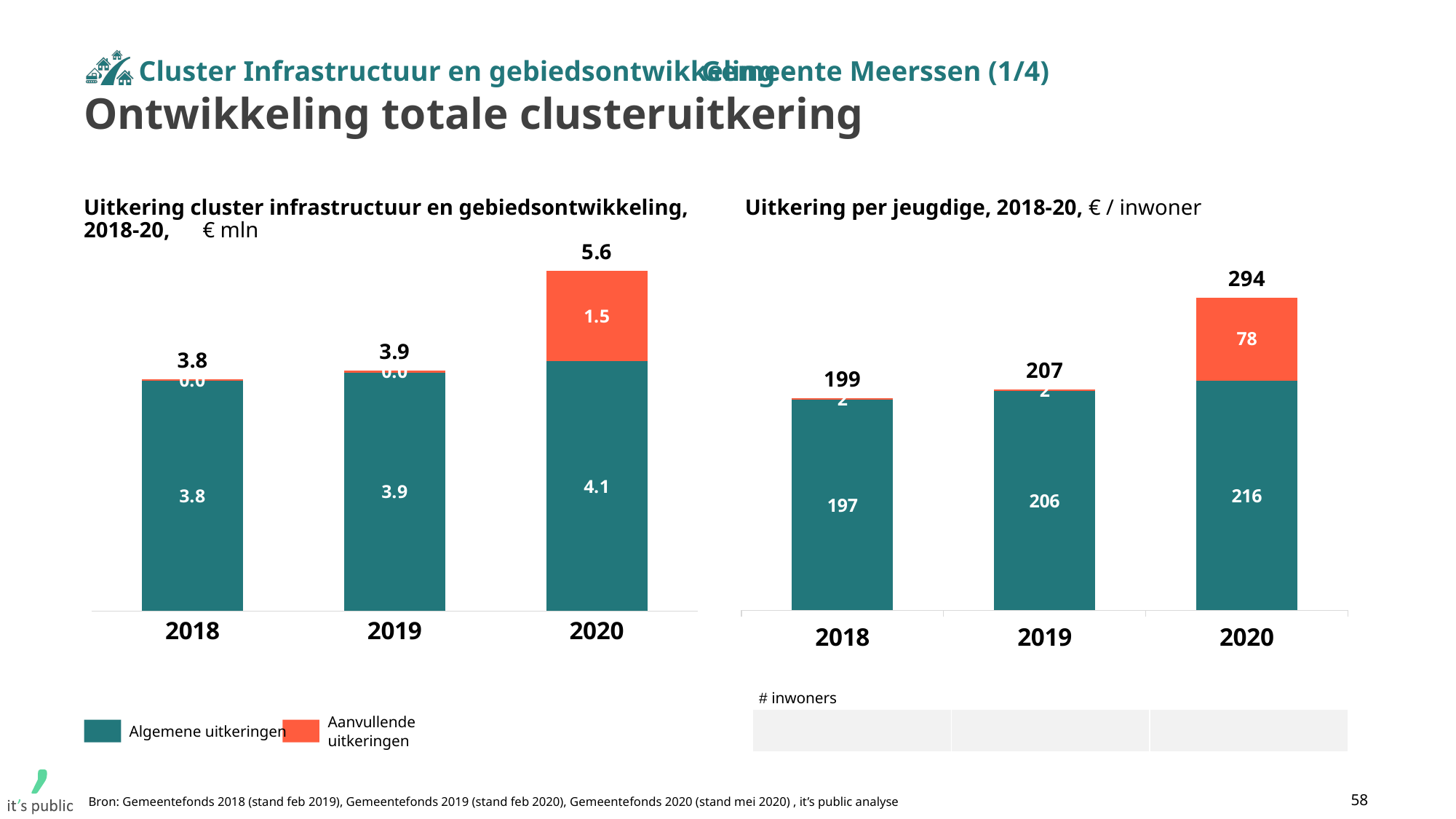
In the right chart (Uitkering per jeugdige), which year has the lowest total? 2018 In the left chart (Uitkering cluster infrastructuur en gebiedsontwikkeling), which year has the highest total? 2020 How many series does the legend list for the left chart? 2 In the left chart (Uitkering cluster infrastructuur en gebiedsontwikkeling), what is the value of Algemene uitkeringen in 2020? 4.1 In the right chart (Uitkering per jeugdige), what is the value of Algemene uitkeringen in 2018? 197 In the right chart (Uitkering per jeugdige), what is the total value for 2019? 207 In the left chart (Uitkering cluster infrastructuur en gebiedsontwikkeling), what is the value of Aanvullende uitkeringen in 2020? 1.5 What kind of chart is the right chart (Uitkering per jeugdige)? stacked bar chart In the right chart (Uitkering per jeugdige), what is the value of Aanvullende uitkeringen in 2020? 78 In the right chart (Uitkering per jeugdige), do the totals rise or fall from 2018 to 2020? rise In the left chart (Uitkering cluster infrastructuur en gebiedsontwikkeling), what is the total value for 2020? 5.6 In the left chart (Uitkering cluster infrastructuur en gebiedsontwikkeling), what is the difference between the totals for 2020 and 2018? 1.8